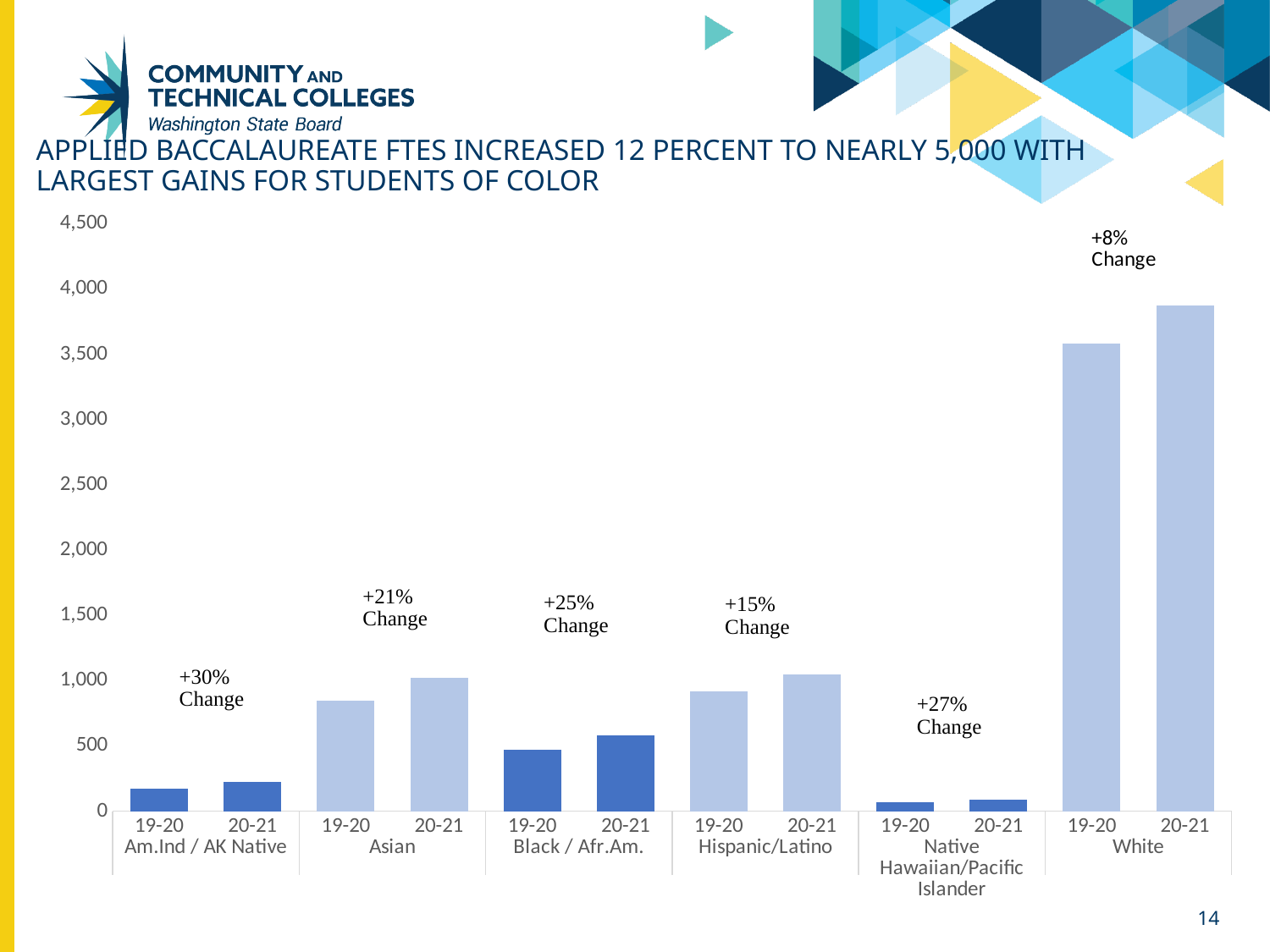
What kind of chart is shown on the slide? Bar chart Which is larger, the 20-21 value for Hispanic/Latino or the 20-21 value for Black / Afr.Am.? Hispanic/Latino What percent change is shown for the Am.Ind / AK Native group? +30% Is the value for White in 20-21 greater or less than 3,500? greater Which group has the lowest FTE bars? Native Hawaiian/Pacific Islander How many race/ethnicity groups are shown along the x axis? 6 Which group has the highest FTE bars? White What percent change is shown for the White group? +8% Within each group, does the value rise or fall from 19-20 to 20-21? Rise Is the value for Asian in 19-20 greater or less than 1,000? less What percent change is shown for the Native Hawaiian/Pacific Islander group? +27% Is the value for Black / Afr.Am. in 20-21 greater or less than 500? greater